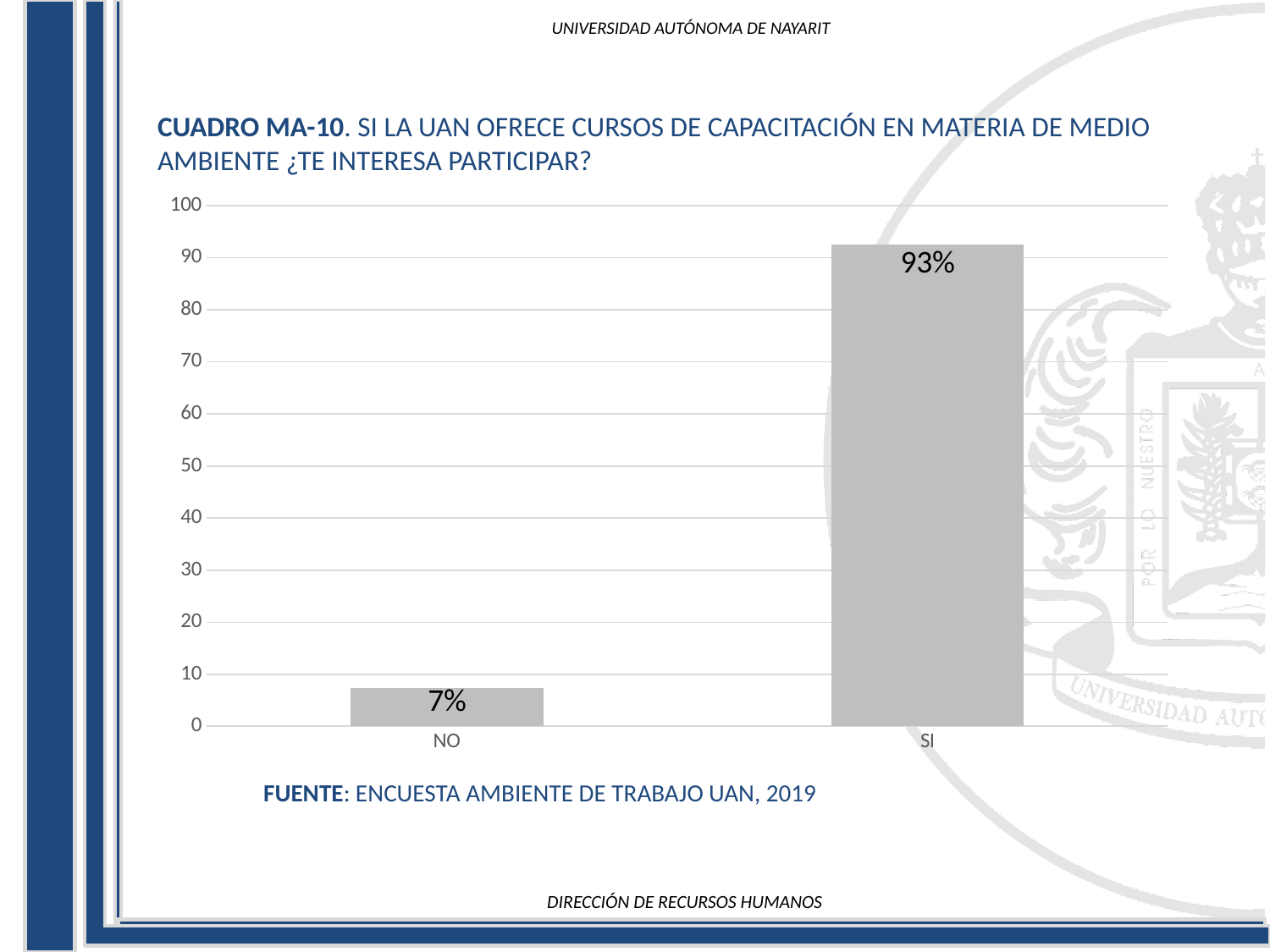
What is the value for NO? 7% Which is larger, the value for NO or the value for SI? SI What is the difference between the values for SI and NO? 86% What is the value for SI? 93% Which category has the highest value? SI What is the maximum value shown on the y axis? 100 Is the value for SI greater or less than 90? greater Which category has the lowest value? NO What kind of chart is shown on the slide? bar chart Is the value for NO greater or less than 10? less What is the source cited below the chart? ENCUESTA AMBIENTE DE TRABAJO UAN, 2019 How many categories are shown on the x axis? 2